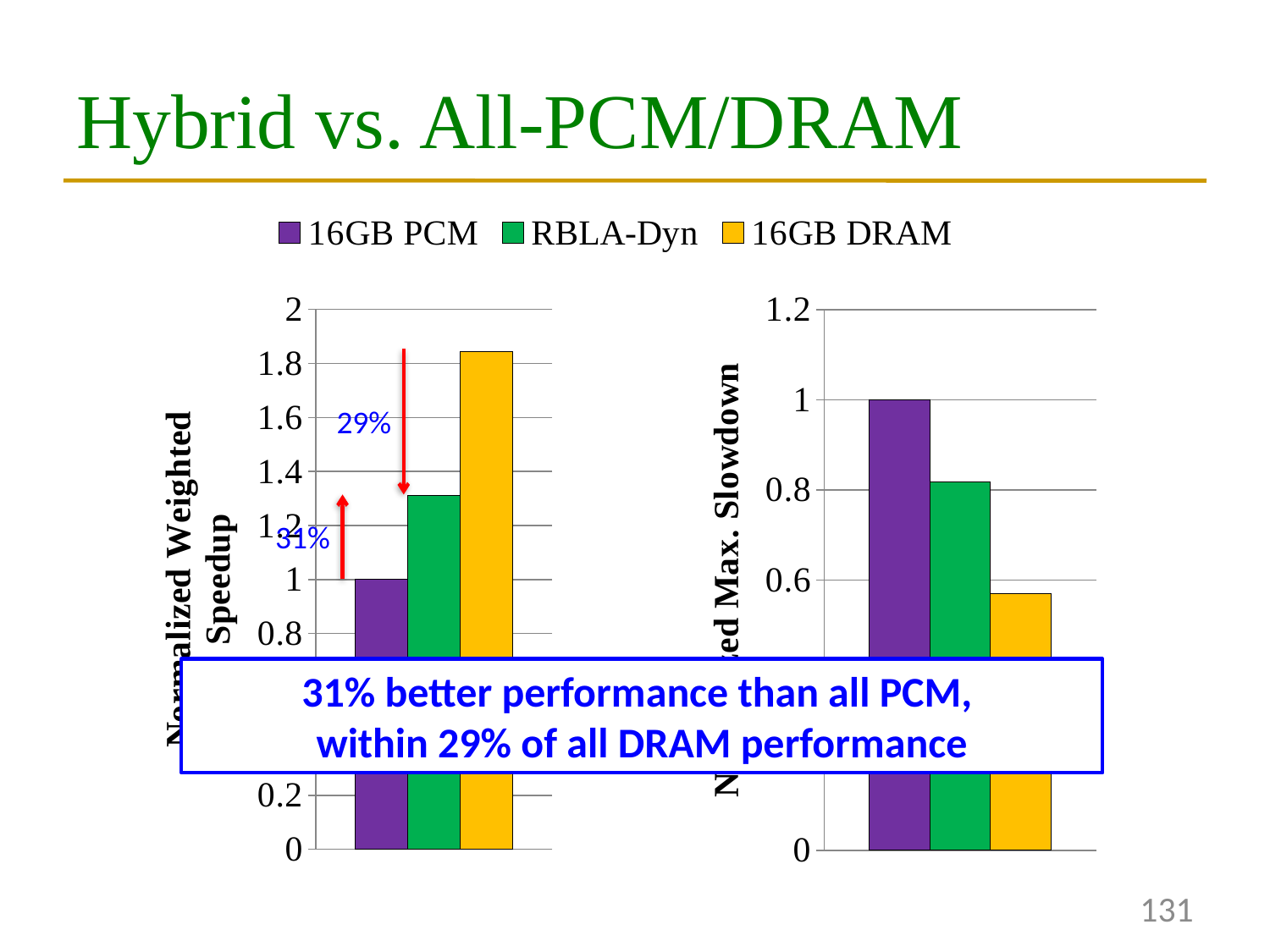
On the Normalized Weighted Speedup chart (left), is the value for 16GB DRAM greater or less than 1.8? greater On the right chart (Normalized Max. Slowdown), is the value for 16GB DRAM greater or less than 0.8? less On the right chart (Normalized Max. Slowdown), which series has the highest value? 16GB PCM How many series does the legend list? 3 What kind of chart is the Normalized Weighted Speedup chart (left)? bar chart On the right chart (Normalized Max. Slowdown), what is the value for 16GB PCM? 1 On the Normalized Weighted Speedup chart (left), which series has the lowest value? 16GB PCM On the right chart (Normalized Max. Slowdown), which is larger, the value for RBLA-Dyn or the value for 16GB DRAM? RBLA-Dyn On the Normalized Weighted Speedup chart (left), is the value for RBLA-Dyn greater or less than 1.2? greater On the right chart (Normalized Max. Slowdown), which series has the lowest value? 16GB DRAM On the Normalized Weighted Speedup chart (left), which series has the highest value? 16GB DRAM On the Normalized Weighted Speedup chart (left), what is the value for 16GB PCM? 1